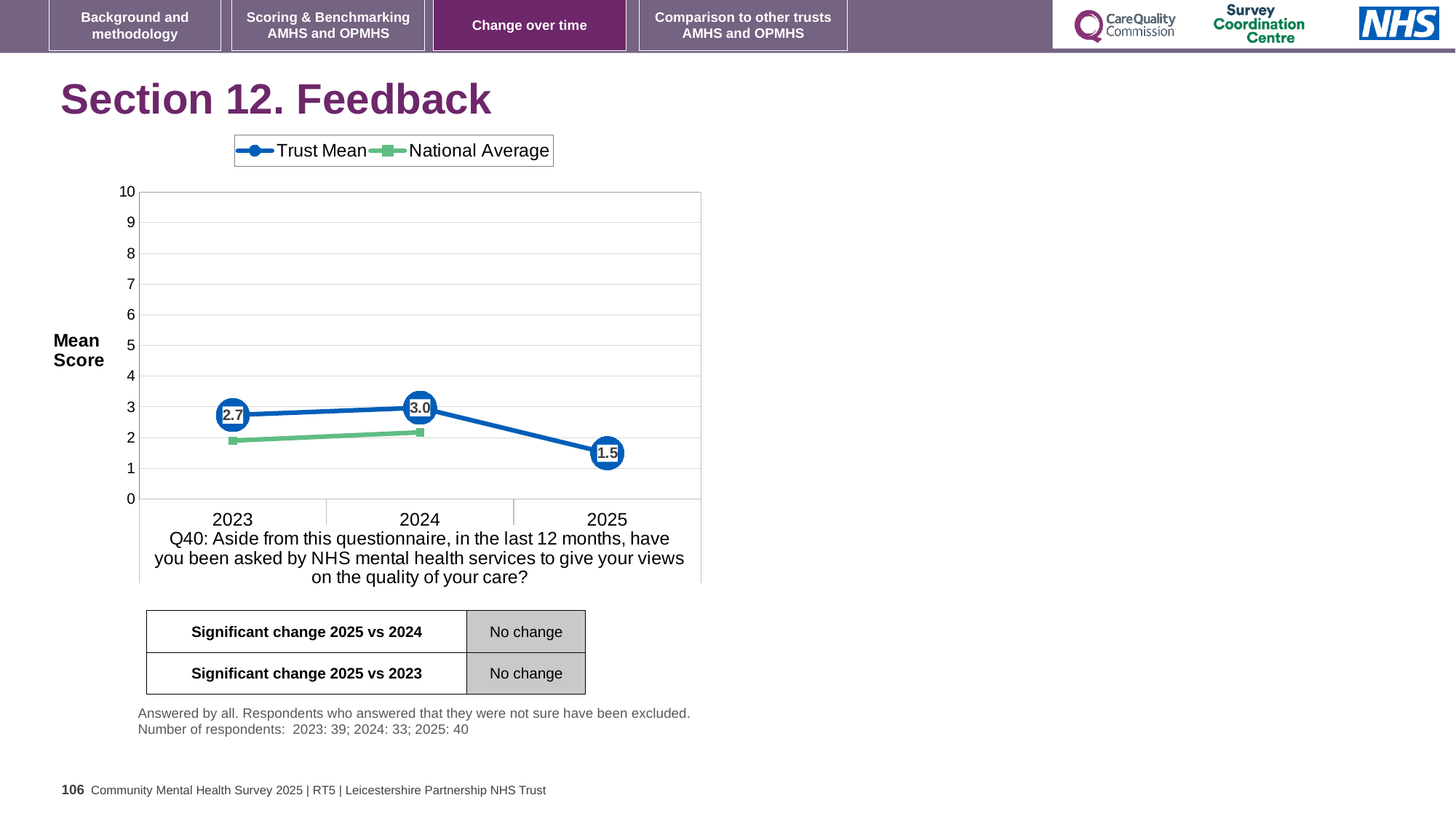
How many years are shown on the x axis? 3 What is the Trust Mean score for 2025? 1.5 What is the difference between the Trust Mean scores for 2024 and 2025? 1.5 Which is larger, the Trust Mean score for 2023 or for 2025? 2023 In which year is the Trust Mean score highest? 2024 What kind of chart is shown on the slide? line chart How many series does the legend list? 2 What is the Trust Mean score for 2024? 3.0 In which year is the Trust Mean score lowest? 2025 Is the National Average value for 2023 greater or less than 3? less Does the Trust Mean rise or fall from 2024 to 2025? fall What is the Trust Mean score for 2023? 2.7